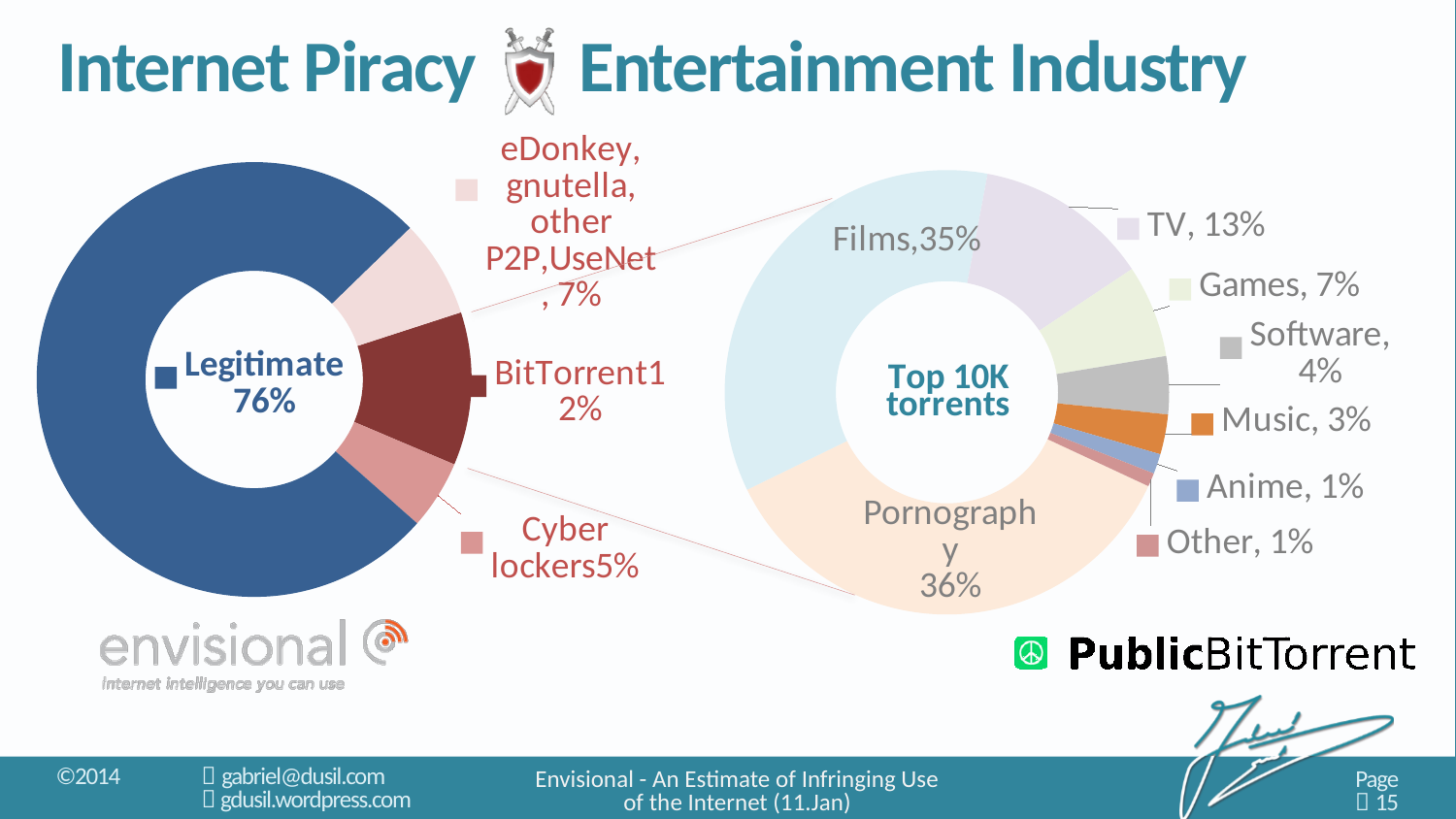
In the left donut chart, what share is labelled Legitimate? 76% In the left donut chart, what is the value for BitTorrent? 12% In the left donut chart, what is the value for Cyber lockers? 5% In the Top 10K torrents chart, which category has the largest share? Pornography In the Top 10K torrents chart, what is the value for TV? 13% How many categories are shown in the Top 10K torrents chart? 8 In the left donut chart, what is the difference between BitTorrent and Cyber lockers? 7% In the left donut chart, which category has the largest share? Legitimate What kind of chart is the Top 10K torrents chart? Donut (pie) chart In the Top 10K torrents chart, which is larger, Games or Software? Games In the Top 10K torrents chart, what is the value for Films? 35% In the left donut chart, which category has the smallest share? Cyber lockers